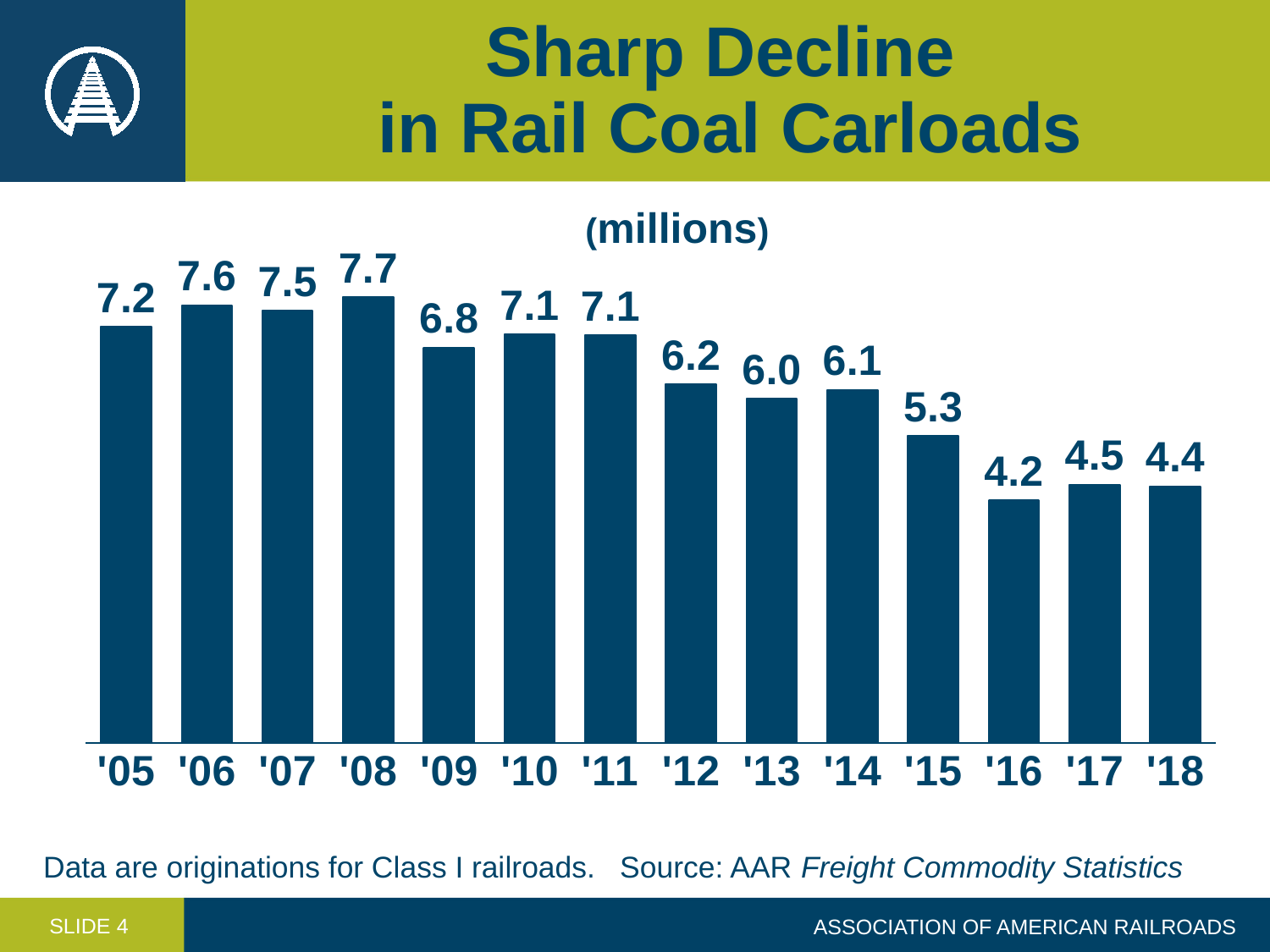
What is the title of the slide? Sharp Decline in Rail Coal Carloads What kind of chart is this? Bar chart Which year has the lowest value? '16 Which is larger, the value for '13 or the value for '14? '14 Which year has the highest value? '08 What is the value for '12? 6.2 What is the value for '08? 7.7 What is the value for '16? 4.2 How many years are shown on the x axis? 14 What unit is shown above the chart? (millions) Do the values generally rise or fall from '05 to '18? Fall What is the difference between the values for '08 and '18? 3.3